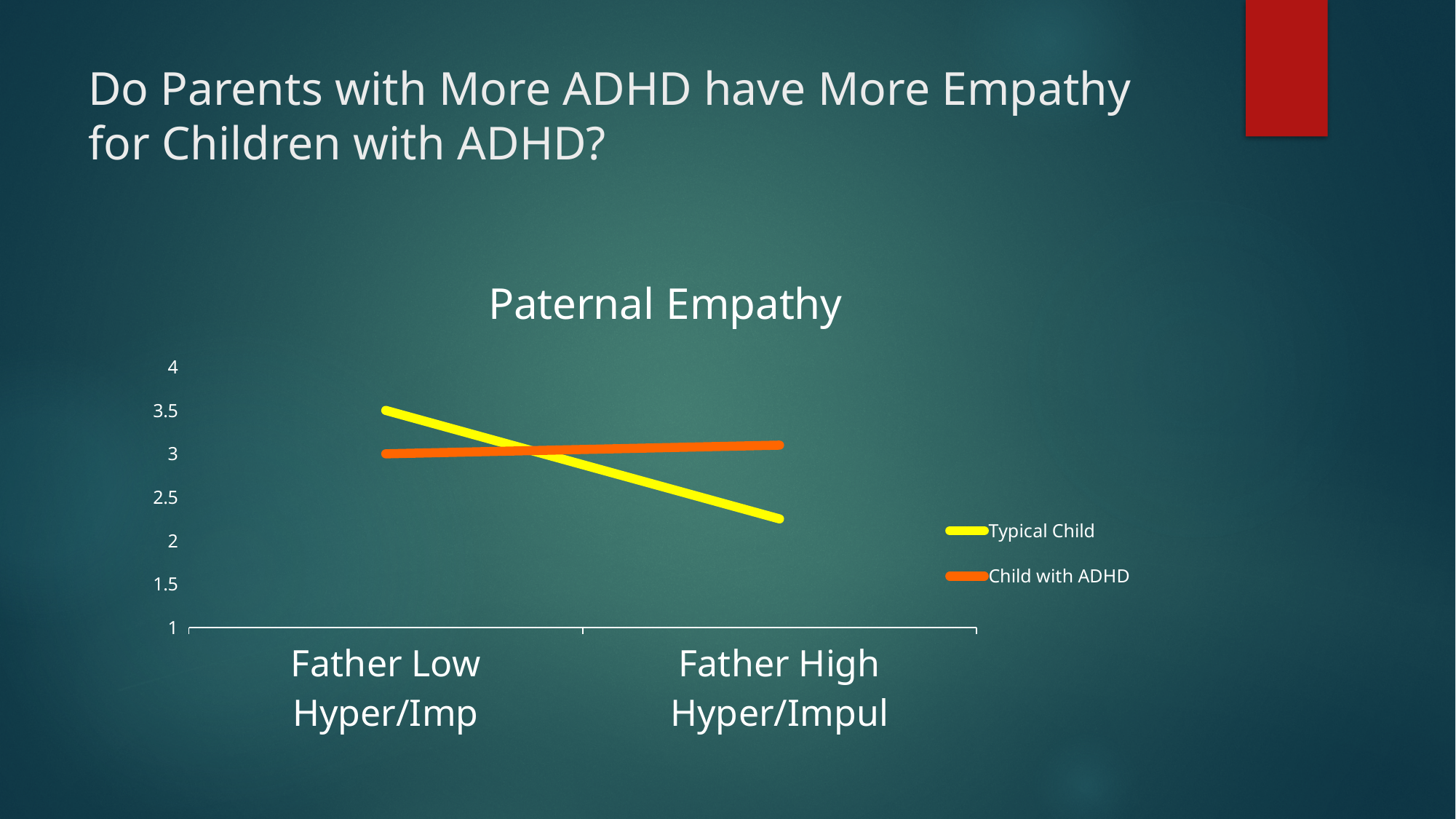
Does the Typical Child line rise or fall from Father Low Hyper/Imp to Father High Hyper/Impul? fall What kind of chart is shown on the slide? line chart How many series does the legend list? 2 At Father Low Hyper/Imp, which series has the higher value, Typical Child or Child with ADHD? Typical Child What is the Child with ADHD value for Father Low Hyper/Imp? 3 At Father High Hyper/Impul, which series has the higher value, Typical Child or Child with ADHD? Child with ADHD Is the Typical Child value for Father High Hyper/Impul greater or less than 2.5? less Which series is drawn in yellow? Typical Child What is the Typical Child value for Father Low Hyper/Imp? 3.5 What is the title of the chart? Paternal Empathy How many categories are shown on the x axis? 2